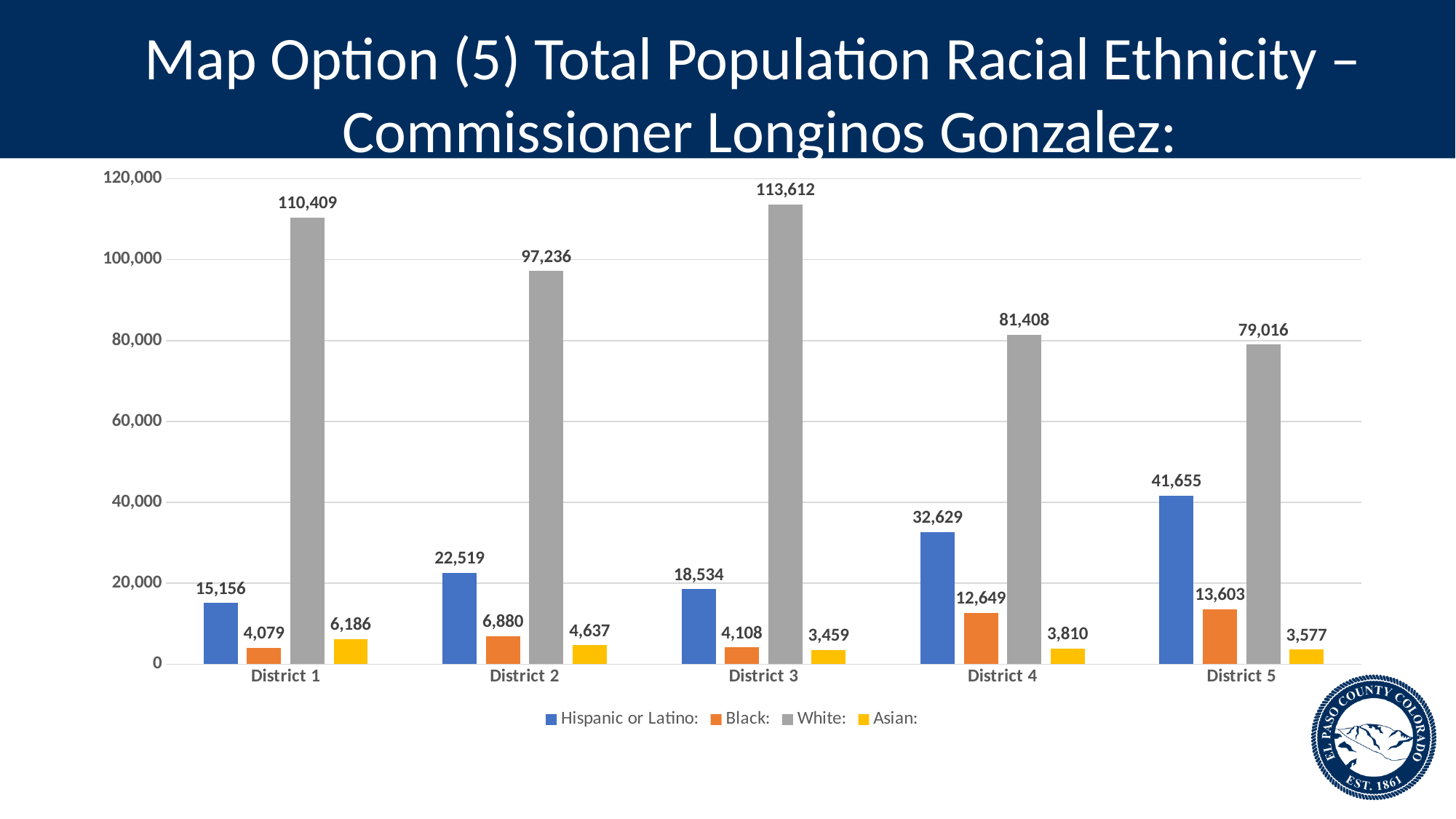
What is the White population value for District 3? 113,612 What kind of chart is shown on the slide? Bar chart What is the Asian population value for District 1? 6,186 Which is larger, the Black population in District 2 or in District 3? District 2 Which district has the lowest Hispanic or Latino population? District 1 How many series does the legend list? 4 What is the Black population value for District 4? 12,649 What is the Hispanic or Latino population value for District 5? 41,655 What is the difference between the White population in District 1 and District 2? 13,173 Is the White population value for District 4 greater or less than 80,000? greater Which district has the highest White population? District 3 How many districts are shown on the x axis? 5